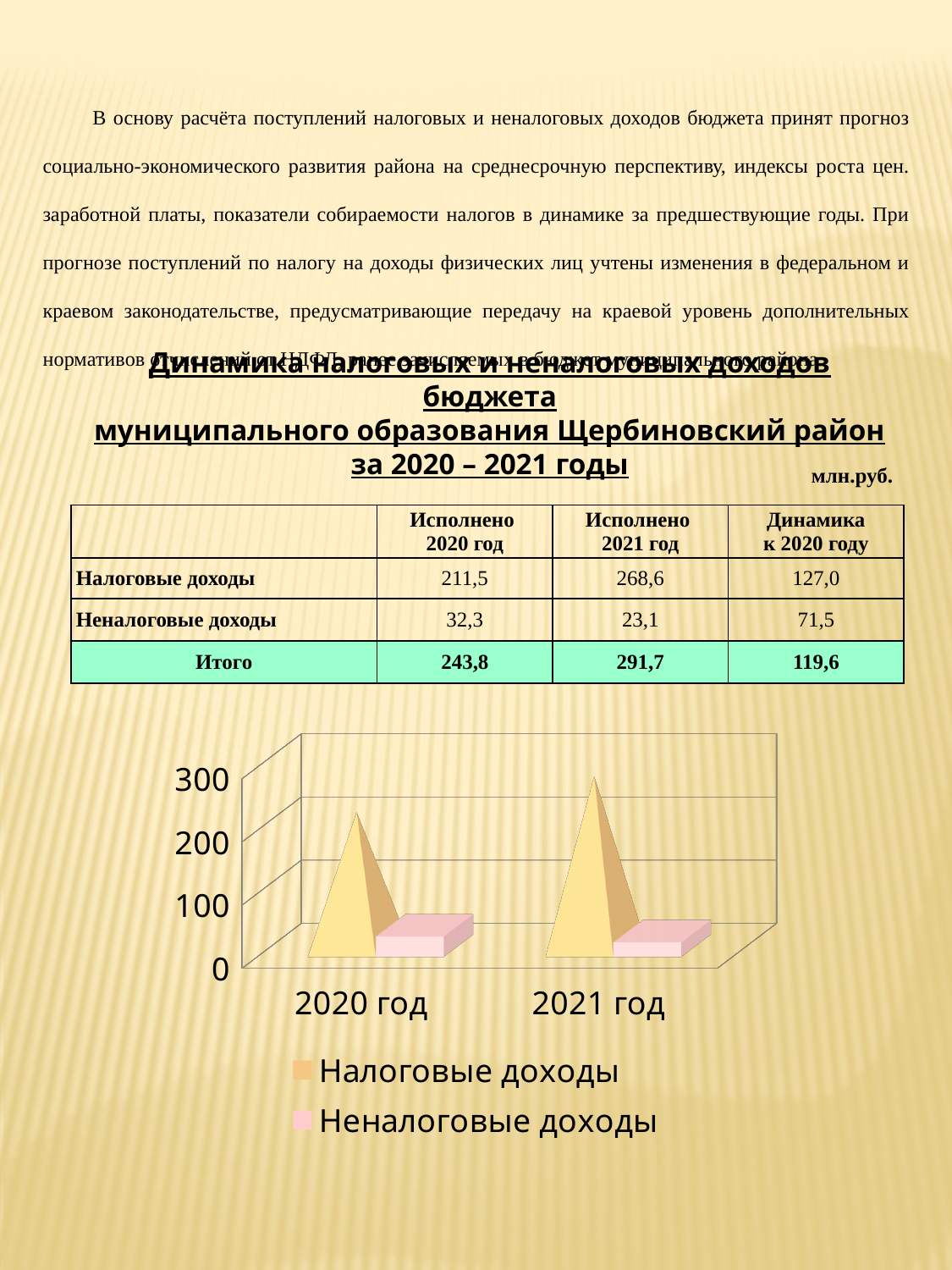
Which series is shown in pink in the chart? Неналоговые доходы According to the slide, what is the value of Налоговые доходы for 2021 год (млн.руб.)? 268,6 What kind of chart is shown on the slide? bar chart How many series does the chart legend list? 2 Which year has the higher value for Налоговые доходы, 2020 год or 2021 год? 2021 год Is the value for Налоговые доходы in 2021 год greater or less than 300? less How many categories are shown on the x axis of the chart? 2 Is the value for Неналоговые доходы in 2020 год greater or less than 100? less According to the slide, what is the value of Неналоговые доходы for 2020 год (млн.руб.)? 32,3 Do the values for Налоговые доходы rise or fall from 2020 год to 2021 год? rise Is the value for Налоговые доходы in 2021 год greater or less than 200? greater By how much did Налоговые доходы increase from 2020 год to 2021 год, based on the values printed on the slide? 57,1